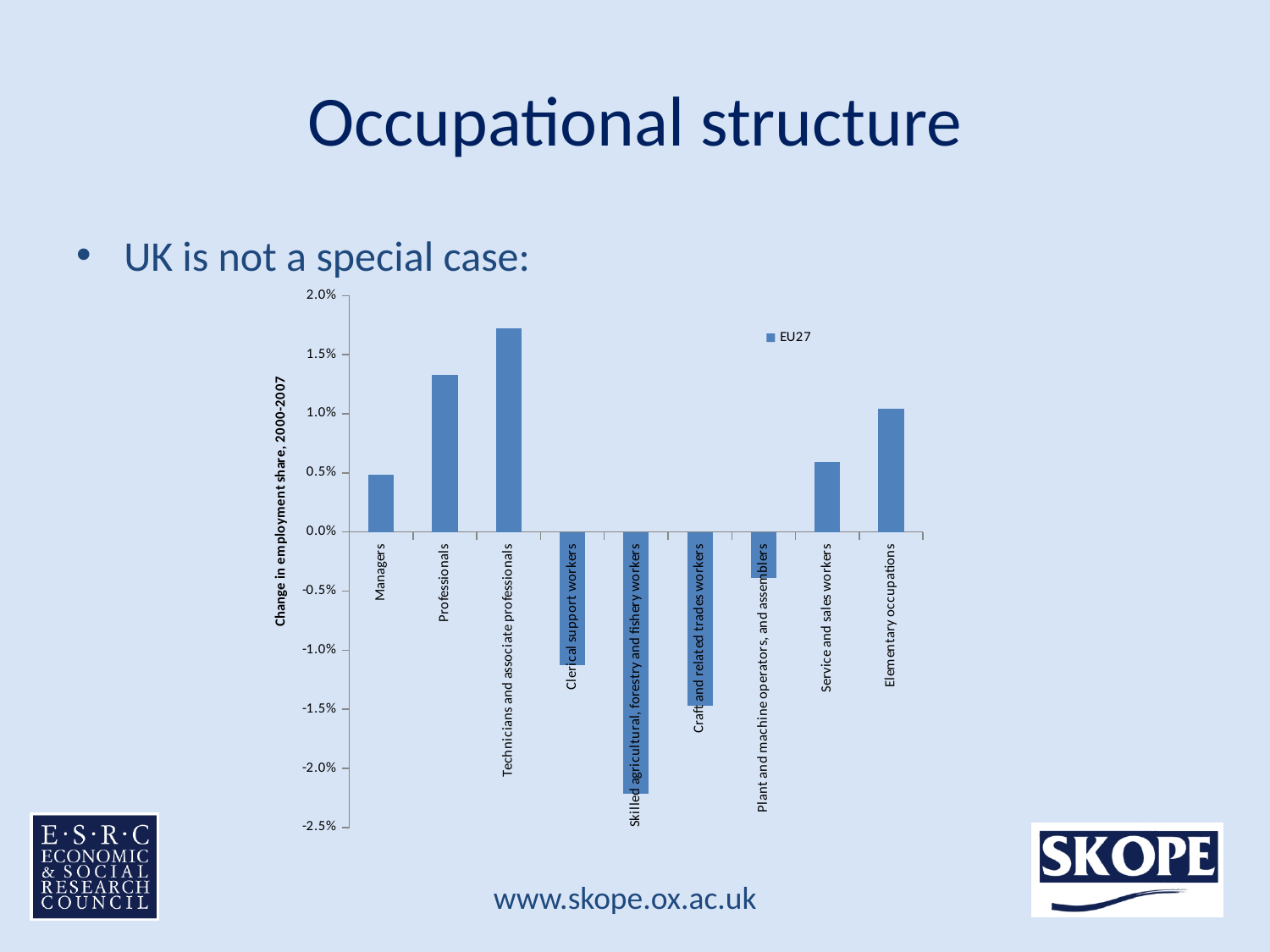
Is the value for Craft and related trades workers greater or less than -1.0%? less Is the value for Skilled agricultural, forestry and fishery workers greater or less than -2.0%? less Which is larger, the value for Managers or the value for Service and sales workers? Service and sales workers Which occupational category has the lowest change in employment share? Skilled agricultural, forestry and fishery workers How many series does the legend list? 1 What series name appears in the legend? EU27 How many occupational categories are plotted on the chart? 9 Which occupational category has the highest change in employment share? Technicians and associate professionals Is the value for Professionals greater or less than 1.0%? greater Which is larger, the value for Professionals or the value for Elementary occupations? Professionals What is the title of the vertical axis? Change in employment share, 2000-2007 What kind of chart is shown on the slide? bar chart